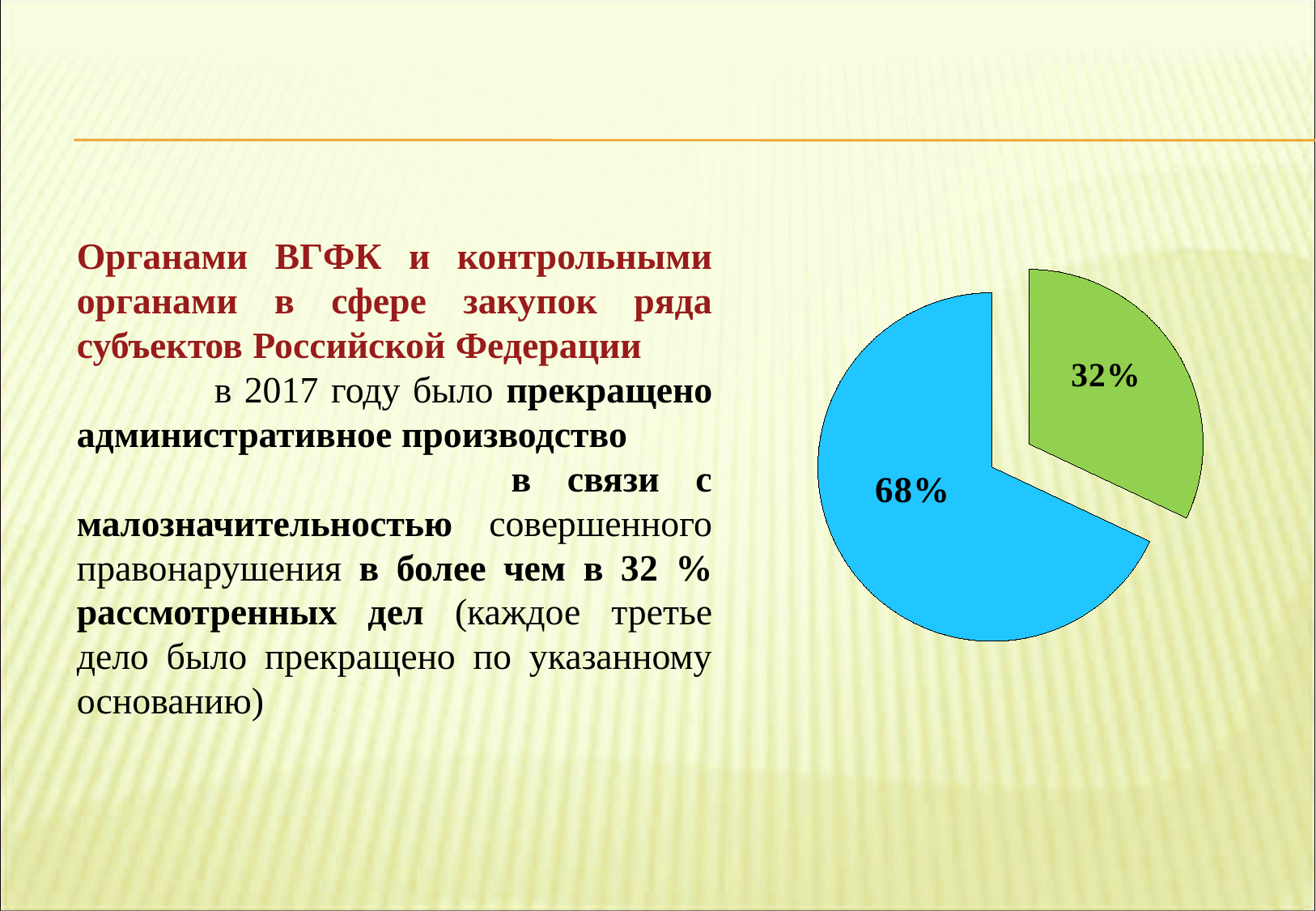
What percentage is shown on the blue slice of the pie chart? 68% Which is larger, the blue slice or the green slice? the blue slice What kind of chart is shown on the slide? pie chart By how many percentage points does the blue slice exceed the green slice? 36 percentage points How many slices does the pie chart have? 2 What share of the pie does the green slice represent? 32% What do the two slices of the pie chart add up to? 100% Does the pie chart have a legend? No What percentage is shown on the green slice of the pie chart? 32% Which slice of the pie chart is pulled out (exploded) from the rest? the green 32% slice Which slice of the pie chart is the largest? the blue slice (68%) Which slice of the pie chart is the smallest? the green slice (32%)